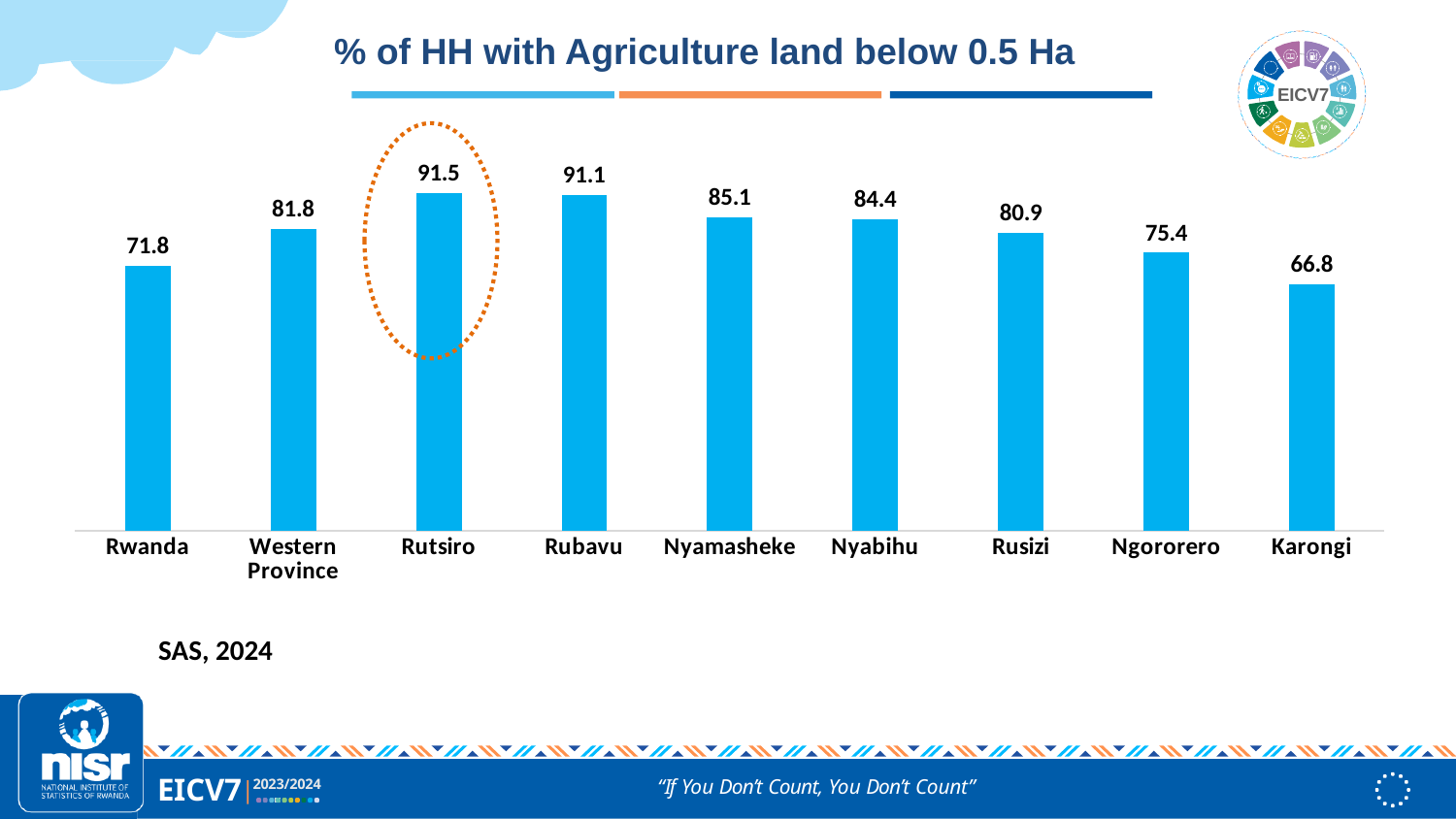
What is the title of the chart? % of HH with Agriculture land below 0.5 Ha What is the value for Nyamasheke? 85.1 Which category has the highest value? Rutsiro What is the difference between the values for Western Province and Rwanda? 10 What is the value for Rutsiro? 91.5 What is the difference between the values for Rutsiro and Karongi? 24.7 Which is larger, the value for Nyabihu or the value for Rusizi? Nyabihu What is the value for Rwanda? 71.8 What kind of chart is shown on the slide? Bar chart How many categories are shown on the x axis? 9 What is the value for Karongi? 66.8 Which category has the lowest value? Karongi